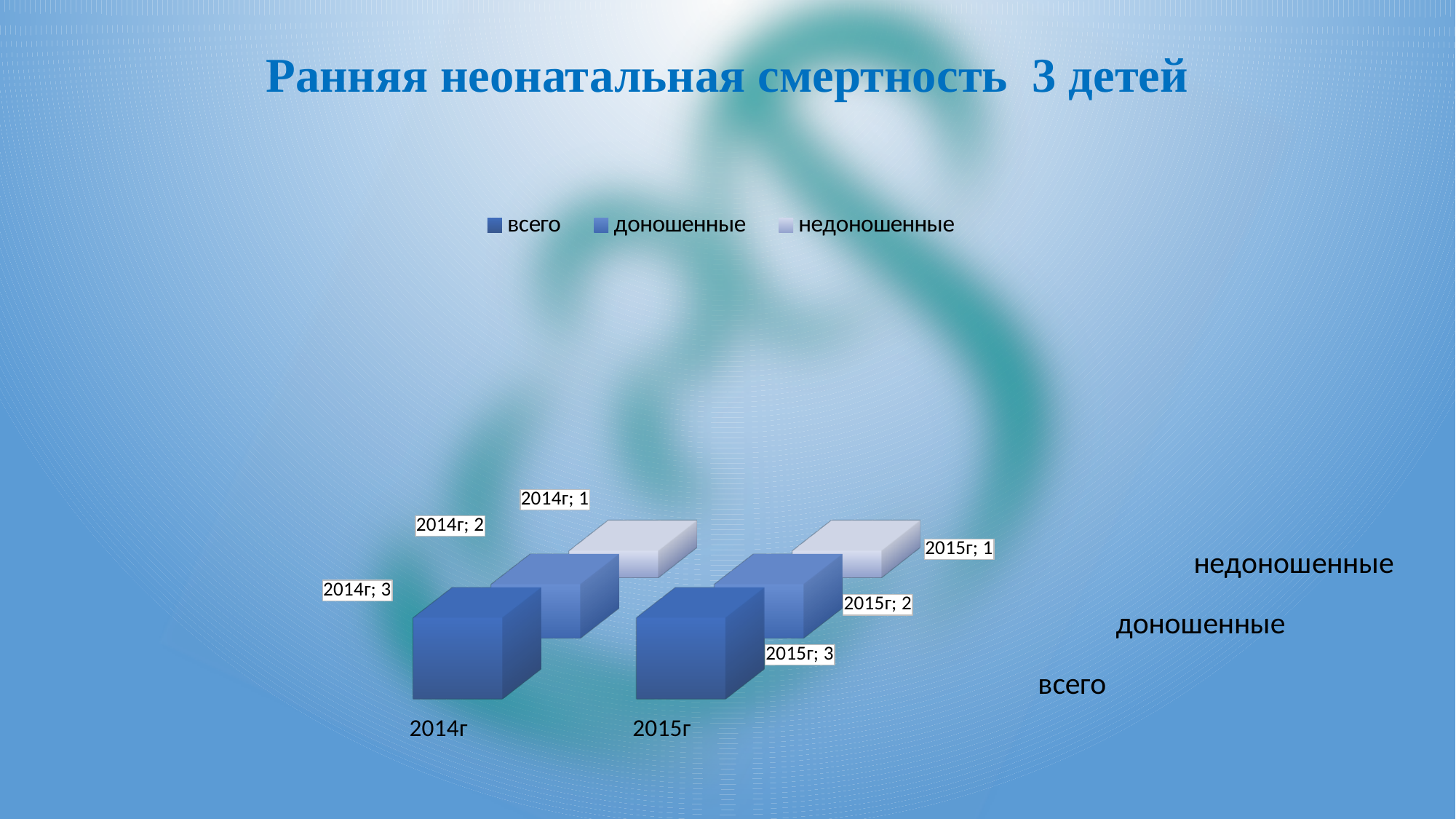
How many series does the legend list? 3 Which series has the lowest value in 2015г? недоношенные What is the value for недоношенные in 2014г? 1 How many year categories are shown on the x axis? 2 Which is larger in 2014г: доношенные or недоношенные? доношенные What is the value for всего in 2015г? 3 What kind of chart is shown on the slide? bar chart What is the title of the slide? Ранняя неонатальная смертность 3 детей What is the value for всего in 2014г? 3 Which series has the highest value in 2014г? всего What is the difference between доношенные and недоношенные in 2015г? 1 What is the value for доношенные in 2015г? 2